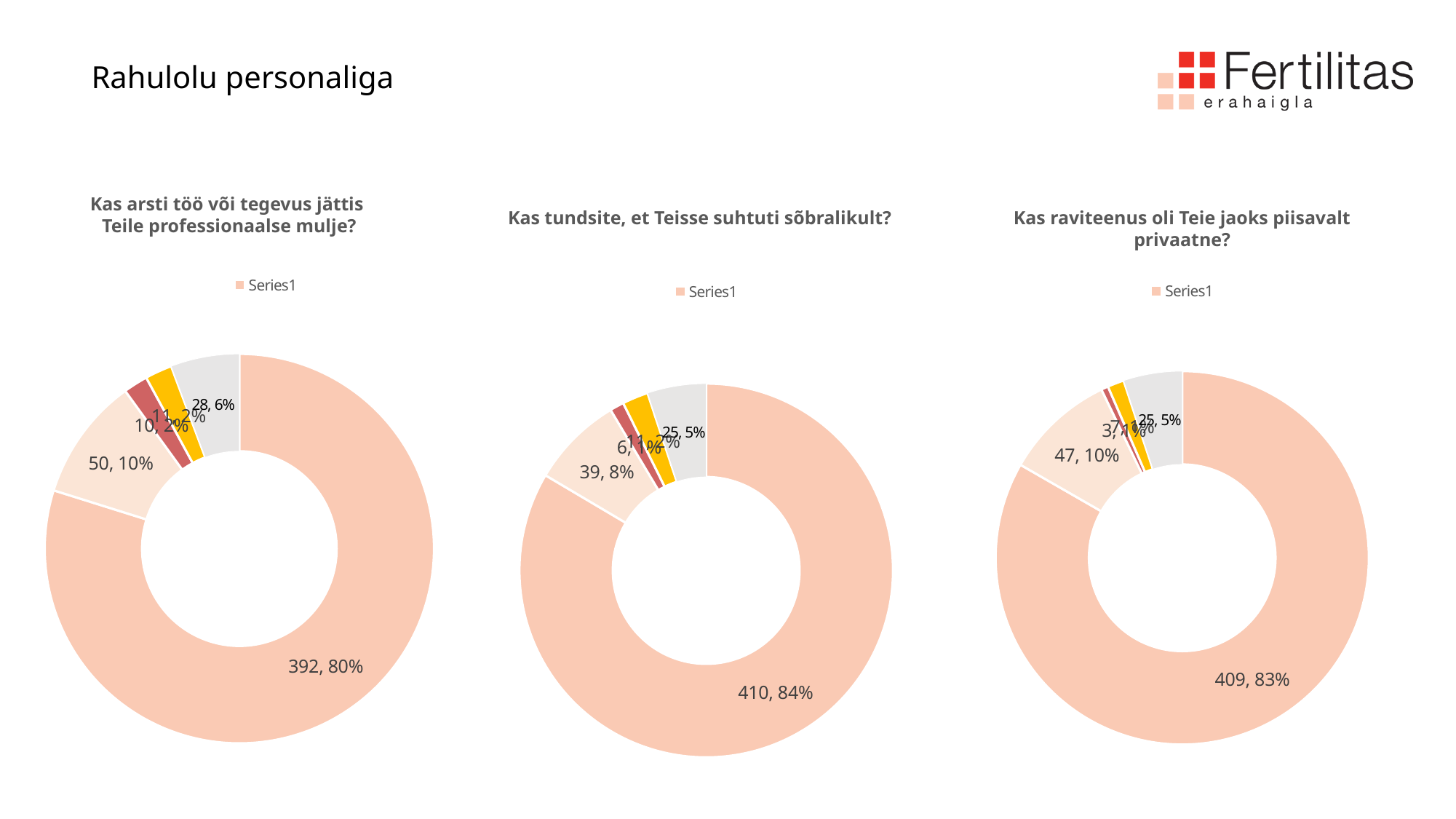
In the middle chart, what is the data label on the grey slice? 25, 5% In the chart titled 'Kas arsti töö või tegevus jättis Teile professionaalse mulje?', what is the data label on the largest slice? 392, 80% How many series does the legend of the left chart list? 1 What kind of chart is used for the three charts on the slide? doughnut chart In the left chart, what share of the pie does the largest slice represent? 80% What is the difference between the largest slice count in the middle chart (410) and the largest slice count in the left chart (392)? 18 Which is larger: the largest slice in the left chart (392) or the largest slice in the middle chart (410)? the middle chart (410) In the chart titled 'Kas tundsite, et Teisse suhtuti sõbralikult?', what is the data label on the largest slice? 410, 84% In the chart titled 'Kas raviteenus oli Teie jaoks piisavalt privaatne?', what is the data label on the largest slice? 409, 83% In the left chart, how many slices does the pie have? 5 In the right chart, what is the data label on the second-largest (light peach) slice? 47, 10% In the left chart, what is the data label on the grey slice? 28, 6%